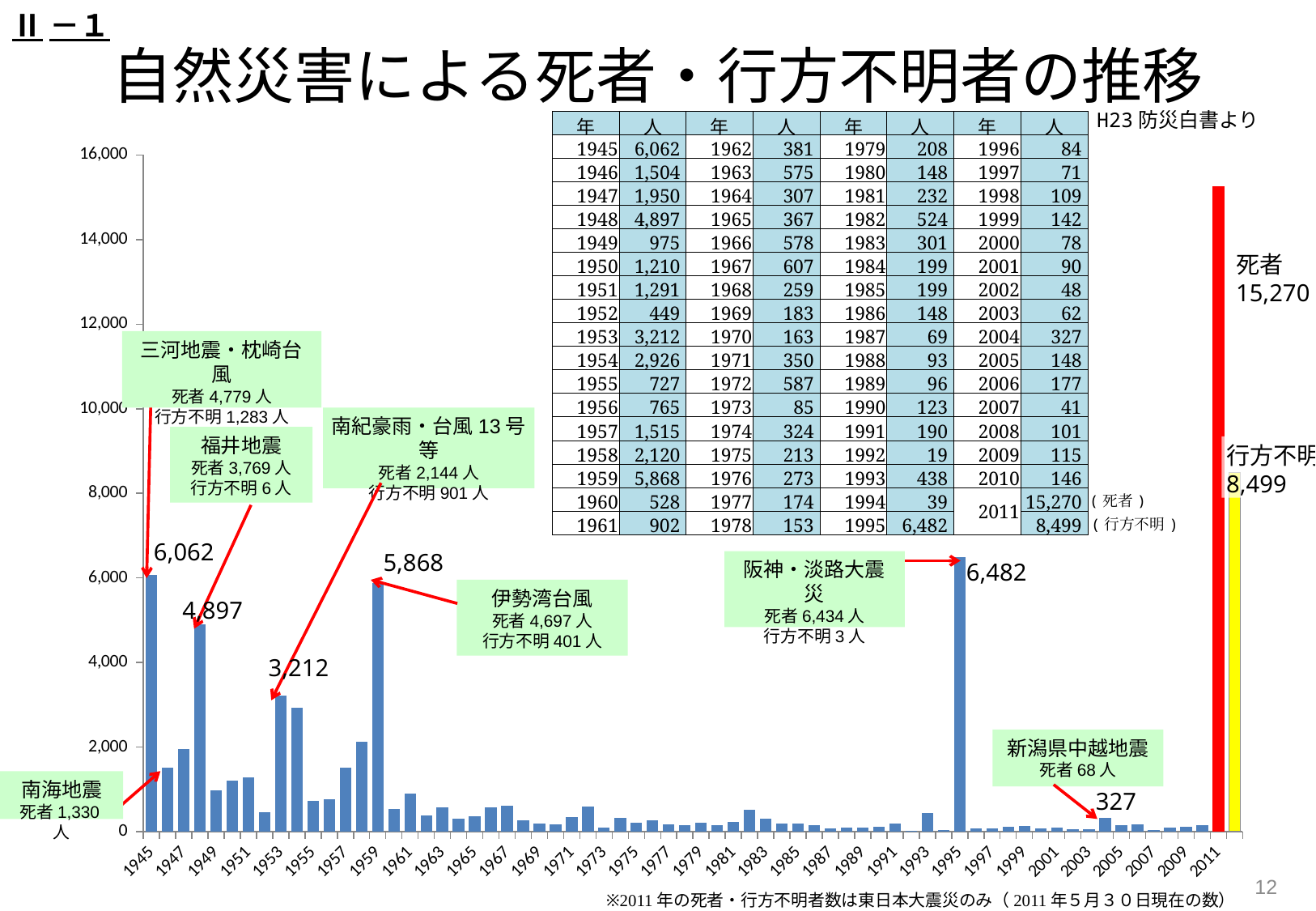
What is the value shown for 1959? 5,868 What kind of chart is shown on the slide? bar chart Which is larger, the value for 1948 or the value for 1953? 1948 What is the difference between the values for 1959 and 1948? 971 What is the difference between the values for 1995 and 1945? 420 What is the number of 死者 (deaths) shown for 2011? 15,270 What is the value shown for 1945? 6,062 Which year has the tallest bar on the chart? 2011 What is the value shown for 1995? 6,482 What colour is the 2011 死者 (deaths) bar? red What is the number of 行方不明 (missing) shown for 2011? 8,499 Is the value for 1954 greater or less than 2,000? greater